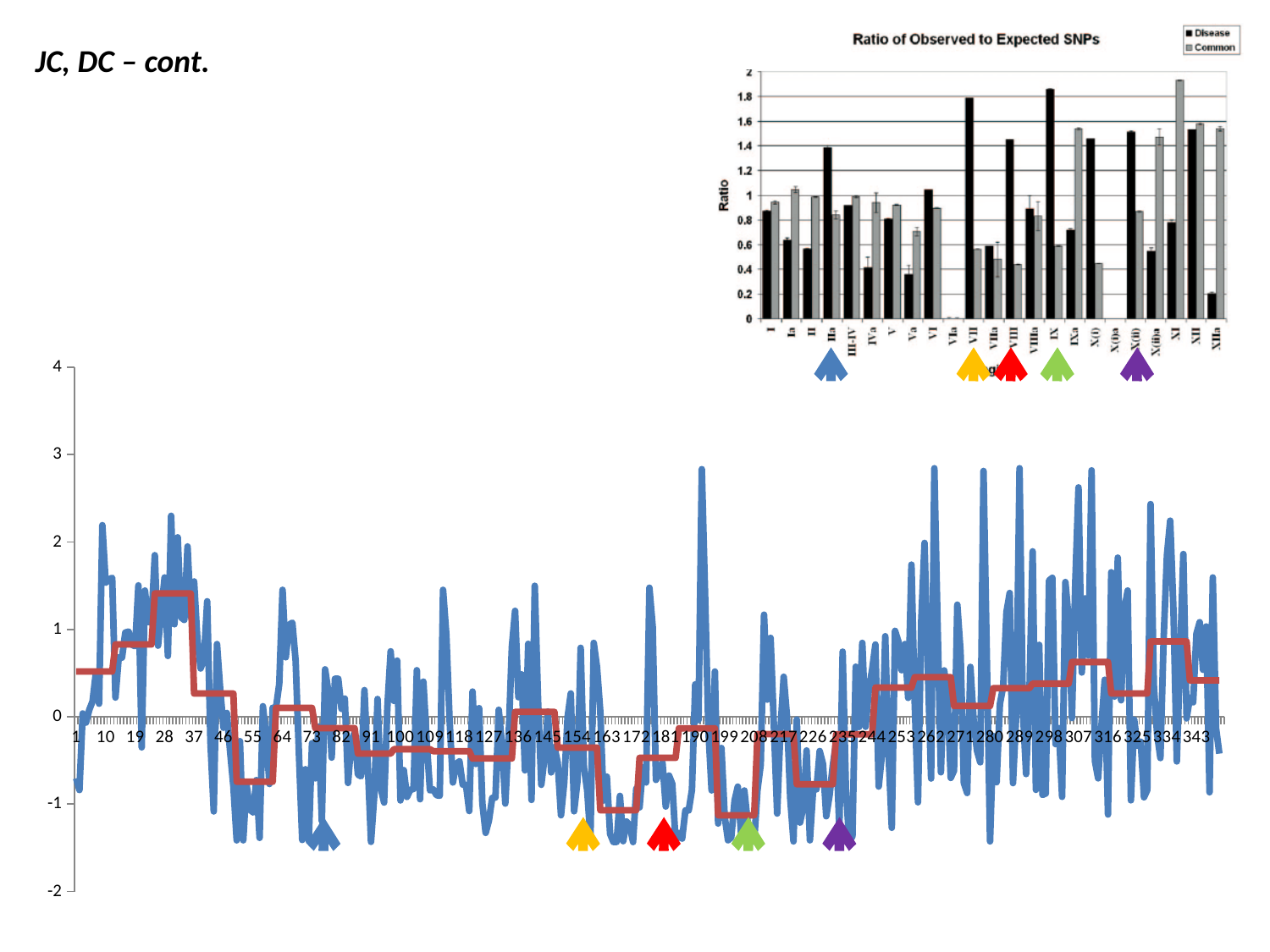
In the large chart at the bottom of the slide, is the red step line around x = 55 greater or less than 0? less What are the two legend entries in the 'Ratio of Observed to Expected SNPs' chart? Disease, Common In the 'Ratio of Observed to Expected SNPs' chart, is the Disease value for XIIa greater or less than 0.4? less In the 'Ratio of Observed to Expected SNPs' chart, is the Disease value for VII greater or less than 1.6? greater What kind of chart is the top-right chart titled 'Ratio of Observed to Expected SNPs'? bar chart In the large chart at the bottom of the slide, what is the highest tick value shown on the y axis? 4 In the 'Ratio of Observed to Expected SNPs' chart, for category IX, which is larger: the Disease bar or the Common bar? Disease In the 'Ratio of Observed to Expected SNPs' chart, which category has the tallest Common bar? XI How many series does the legend of the 'Ratio of Observed to Expected SNPs' chart list? 2 In the 'Ratio of Observed to Expected SNPs' chart, for category XI, which is larger: the Disease bar or the Common bar? Common What is the y-axis label of the 'Ratio of Observed to Expected SNPs' chart? Ratio What kind of chart is the large chart at the bottom of the slide? line chart